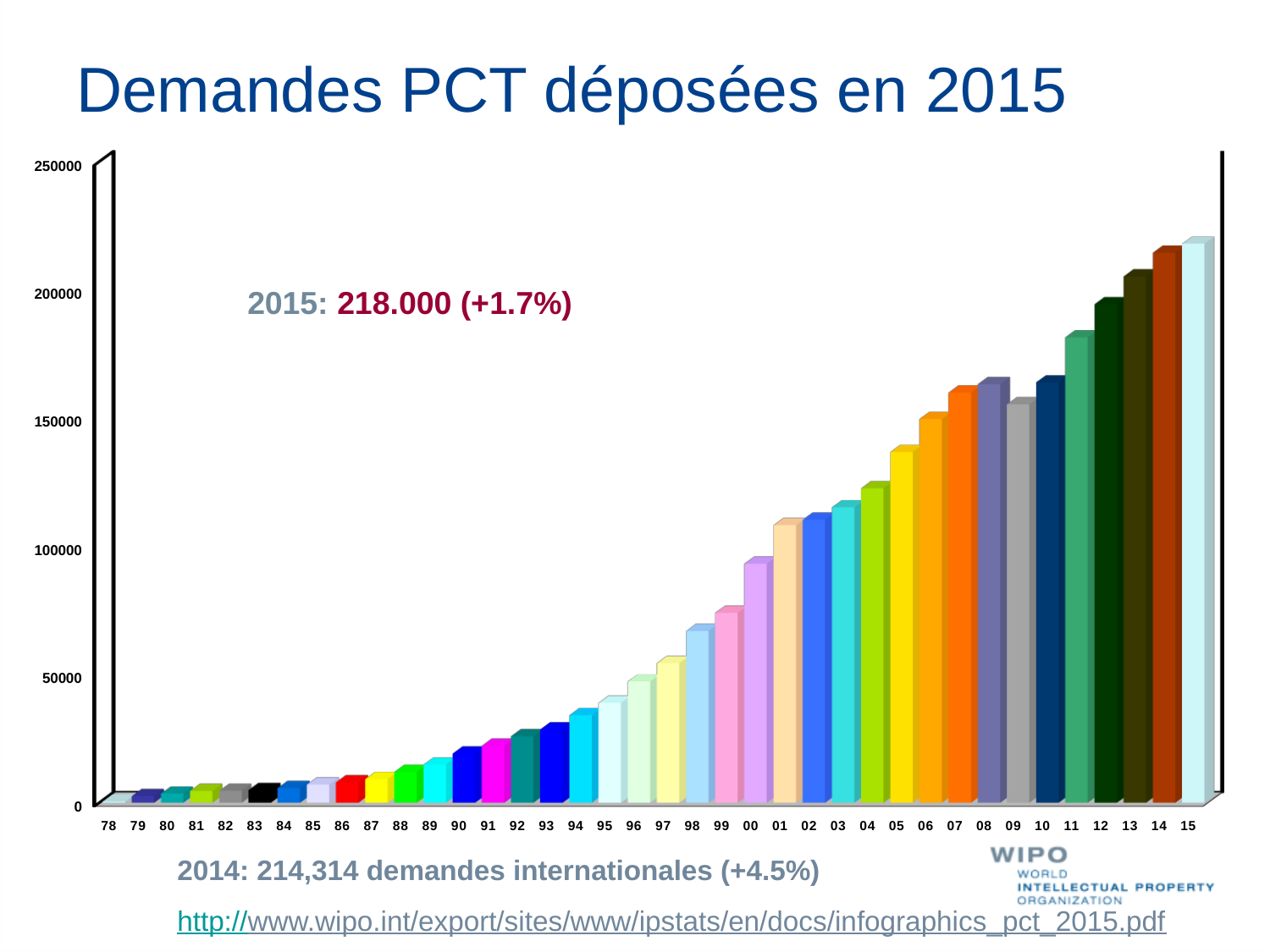
Is the value for 10 greater or less than 150000? greater Which year has the larger value, 08 or 09? 08 Which year has the highest number of PCT applications? 15 Which year has the lowest number of PCT applications? 78 According to the slide, how many PCT applications were filed in 2015? 218.000 How many years (bars) are plotted on the chart? 38 Is the value for 00 greater or less than 100000? less According to the slide, how many international applications were filed in 2014? 214,314 What is the title of the slide's chart? Demandes PCT déposées en 2015 What kind of chart is shown on the slide? bar chart What percentage growth is given for 2015? +1.7% Do the values generally rise or fall from 78 to 15? rise